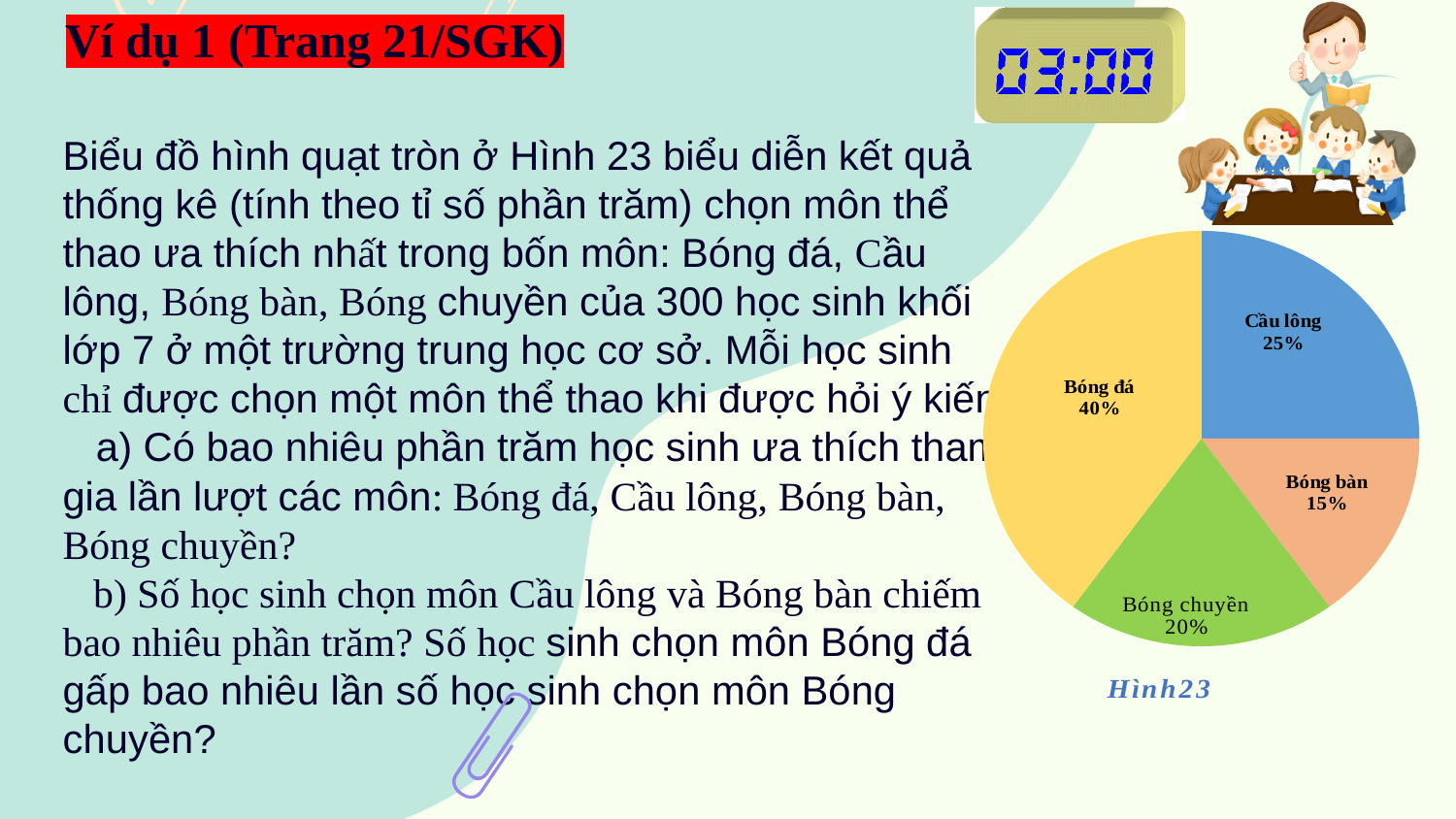
What percentage of the pie chart is labelled Cầu lông? 25% What percentage of the pie chart is labelled Bóng bàn? 15% What is the difference in percentage points between the Cầu lông slice and the Bóng bàn slice? 10% Which slice is larger, Cầu lông or Bóng chuyền? Cầu lông Which sport has the largest slice in the pie chart? Bóng đá How many slices does the pie chart have? 4 Which sport has the smallest slice in the pie chart? Bóng bàn What is the caption printed below the pie chart? Hình23 What is the difference in percentage points between the Bóng đá slice and the Bóng chuyền slice? 20% What type of chart is shown on the slide? Pie chart What percentage of the pie chart is labelled Bóng chuyền? 20% What percentage of the pie chart is labelled Bóng đá? 40%